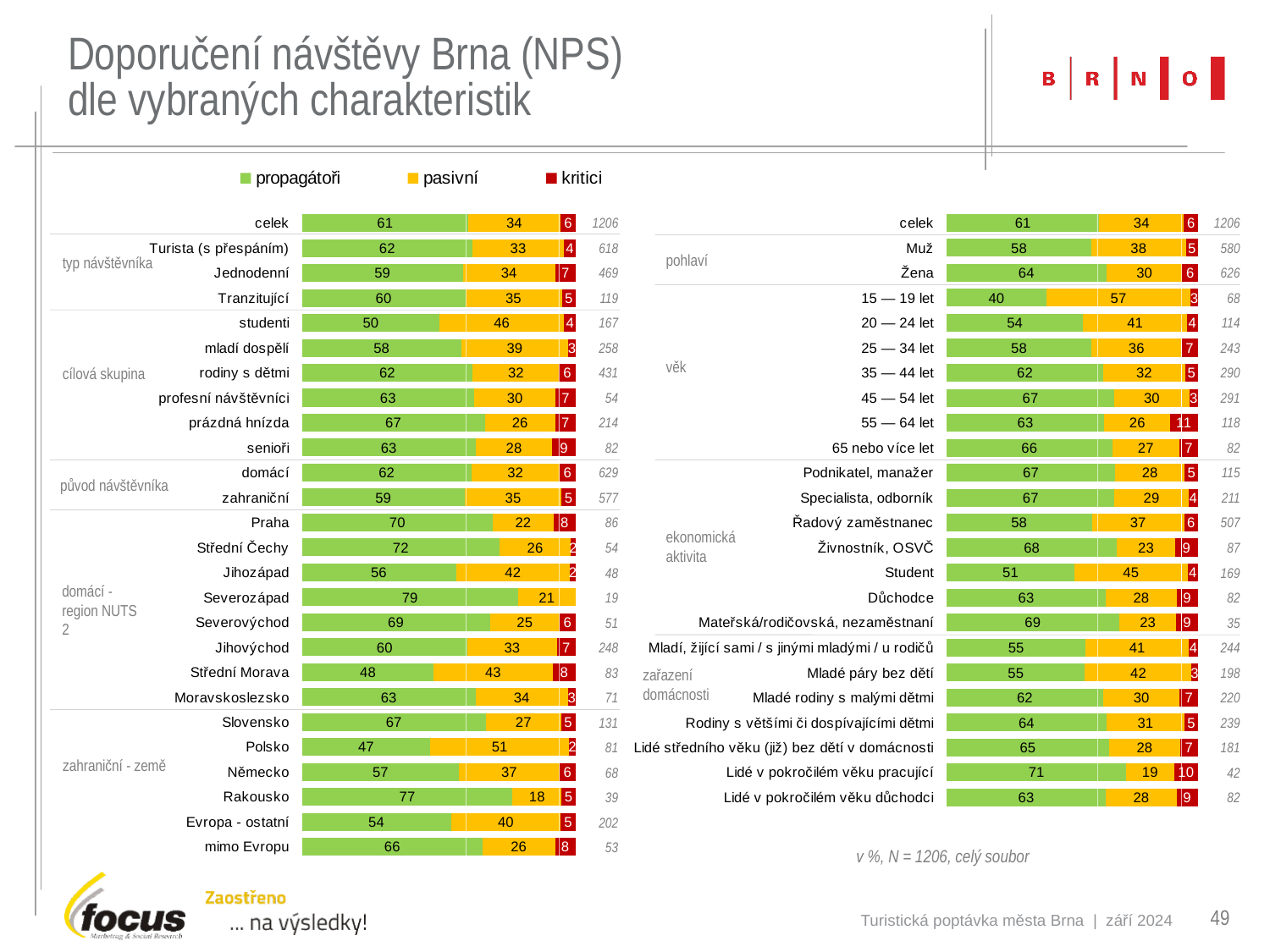
In the left chart, which category has the lowest propagátoři value? Polsko How many series does the legend list? 3 In the right chart, what is the propagátoři value for 15 — 19 let? 40 In the left chart, what is the pasivní value for Rakousko? 18 In the left chart, what is the propagátoři value for Polsko? 47 In the right chart, which category has the lowest propagátoři value? 15 — 19 let In the right chart, which has the larger pasivní value, Muž or Žena? Muž In the left chart, what is the difference between the propagátoři values for Praha and Jihovýchod? 10 In the left chart, which category has the highest propagátoři value? Severozápad What kind of chart is shown on the left side of the slide? Stacked bar chart In the right chart, which category has the highest propagátoři value? Lidé v pokročilém věku pracující In the right chart, what is the kritici value for 55 — 64 let? 11